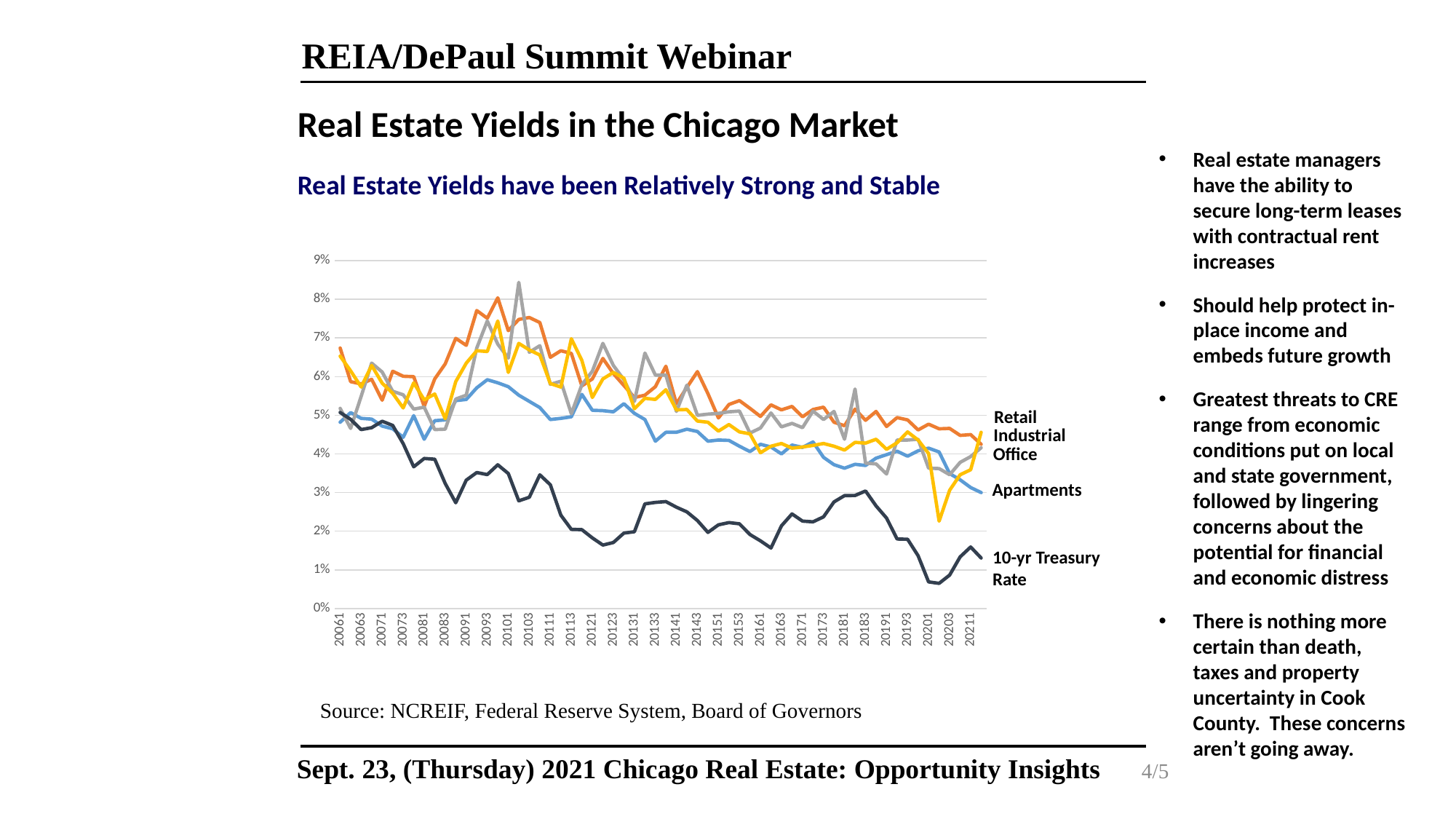
Is the peak Office value around 20101 greater or less than 8%? greater Does the 10-yr Treasury Rate generally rise or fall from 20061 to 20211? fall Is the Industrial value at 20203 greater or less than 3%? greater Which series reaches the highest value anywhere on the chart? Office What kind of chart is shown on the slide? line chart Is the 10-yr Treasury Rate at 20201 greater or less than 1%? less Which series has the lowest value at the right end of the chart (20211)? 10-yr Treasury Rate Which series is labelled at the bottom of the chart, below Apartments? 10-yr Treasury Rate Does the Apartments series generally rise or fall from 20093 to 20211? fall At 20203, which is higher, Industrial or Apartments? Industrial What source is cited below the chart? NCREIF, Federal Reserve System, Board of Governors How many series are labelled on the chart? 5